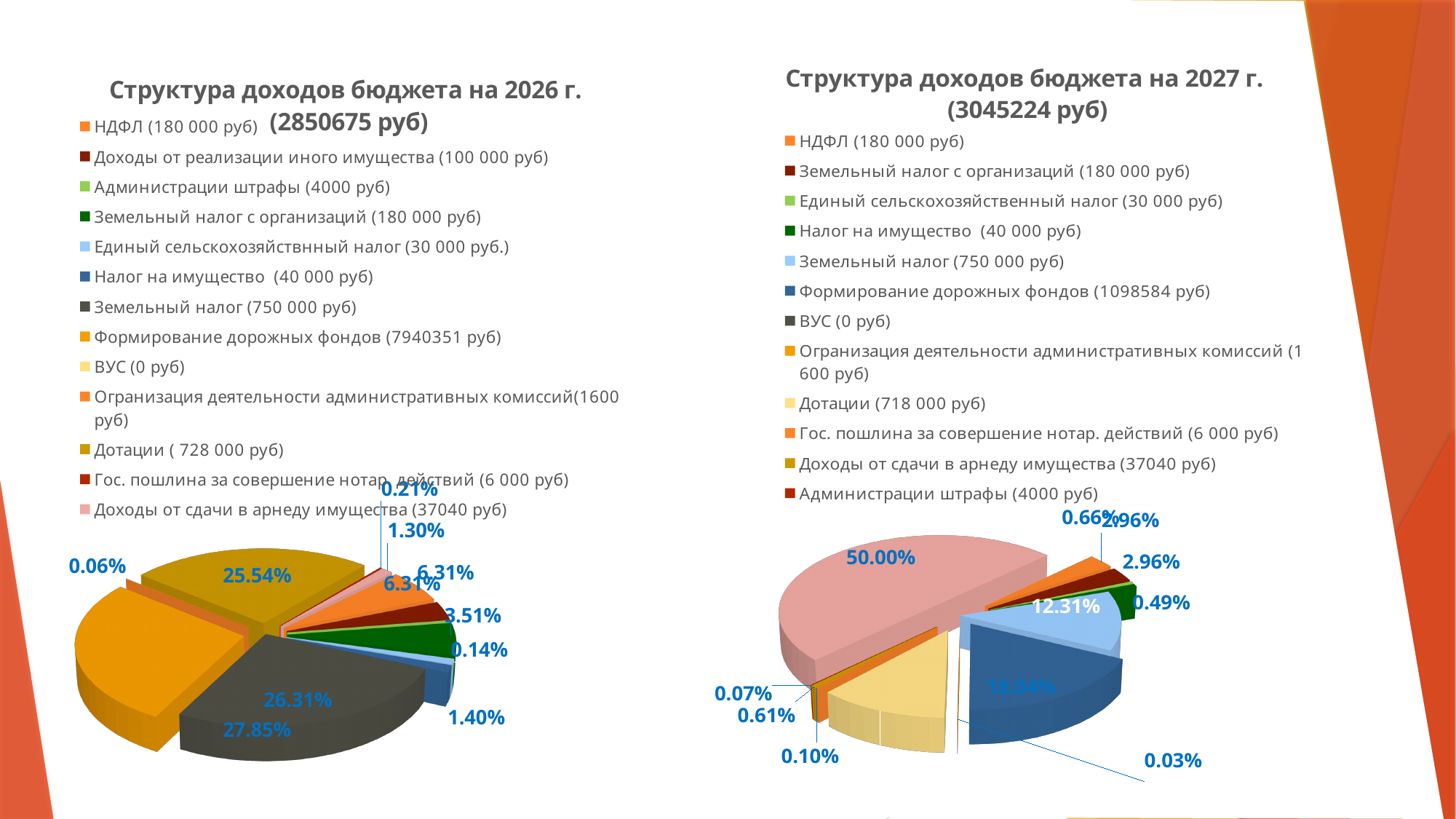
In the right chart 'Структура доходов бюджета на 2027 г.', what is the largest percentage labelled on a slice? 50.00% In the right chart 'Структура доходов бюджета на 2027 г.', how many categories does the legend list? 12 In the right chart 'Структура доходов бюджета на 2027 г.', what is the smallest percentage labelled on a slice? 0.03% In the right chart 'Структура доходов бюджета на 2027 г.', what is the difference between the slices labelled 18.04% and 12.31%? 5.73% What total budget revenue is given in the title of the left chart for 2026? 2850675 руб In the left chart 'Структура доходов бюджета на 2026 г.', what amount does the legend give for 'Земельный налог'? 750 000 руб In the right chart 'Структура доходов бюджета на 2027 г.', what amount does the legend give for 'Формирование дорожных фондов'? 1098584 руб In the left chart 'Структура доходов бюджета на 2026 г.', which labelled share is larger: 27.85% or 25.54%? 27.85% In the left chart 'Структура доходов бюджета на 2026 г.', what is the largest percentage labelled on a slice? 27.85% What total budget revenue is given in the title of the right chart for 2027? 3045224 руб In the left chart 'Структура доходов бюджета на 2026 г.', how many categories does the legend list? 13 What kind of chart is the left chart, 'Структура доходов бюджета на 2026 г.'? pie chart